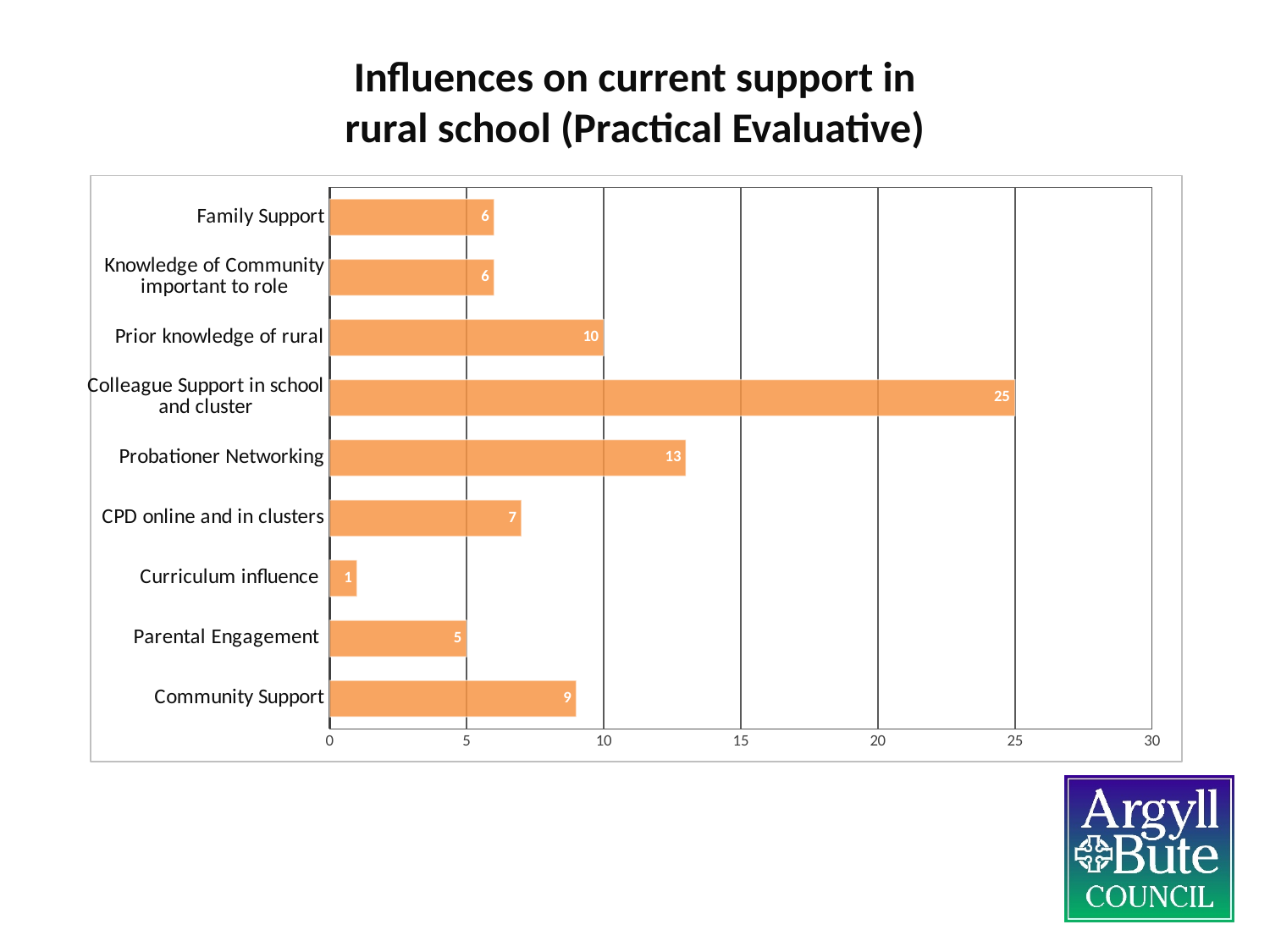
What kind of chart is shown on the slide? bar chart What is the value for Probationer Networking? 13 What is the title of the chart? Influences on current support in rural school (Practical Evaluative) What is the difference between the values for Colleague Support in school and cluster and Probationer Networking? 12 What is the value for Community Support? 9 How many categories are shown in the chart? 9 Which category has the highest value? Colleague Support in school and cluster Which is larger, the value for CPD online and in clusters or the value for Community Support? Community Support Is the value for Probationer Networking greater or less than 10? greater What is the value for Colleague Support in school and cluster? 25 Which category has the lowest value? Curriculum influence What is the difference between the values for Prior knowledge of rural and Parental Engagement? 5